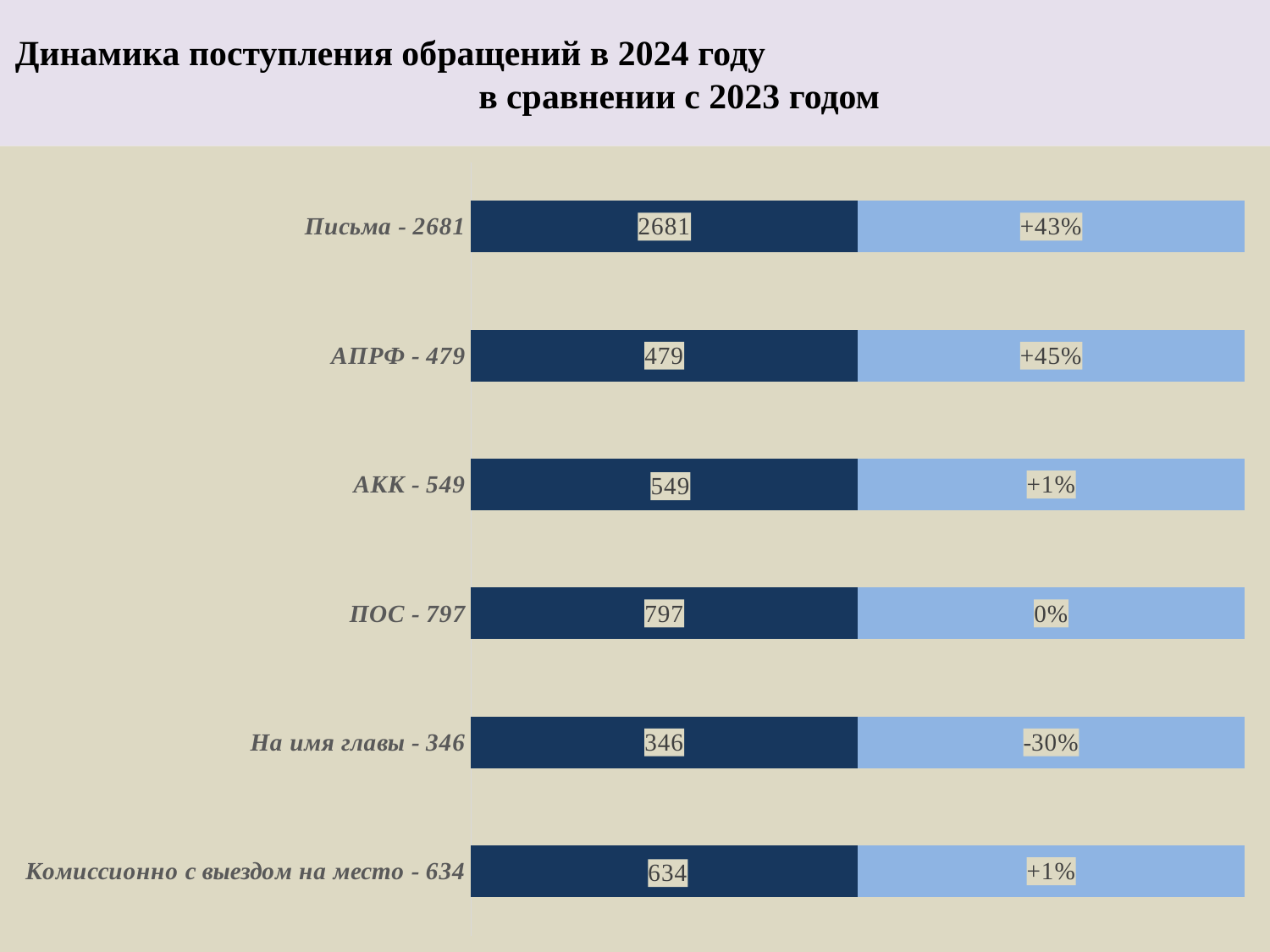
Which category has the highest printed count? Письма What is the value printed on the dark blue bar for ПОС? 797 What percentage change is printed for АПРФ? +45% How many categories are shown in the chart? 6 What is the value printed on the dark blue bar for Письма? 2681 Which category has the lowest printed count? На имя главы What percentage change is printed for На имя главы? -30% Which has the larger printed count, АКК or АПРФ? АКК What kind of chart is shown on the slide? Bar chart What is the title of the slide? Динамика поступления обращений в 2024 году в сравнении с 2023 годом What percentage change is printed for ПОС? 0% What is the difference between the printed counts for ПОС and Комиссионно с выездом на место? 163